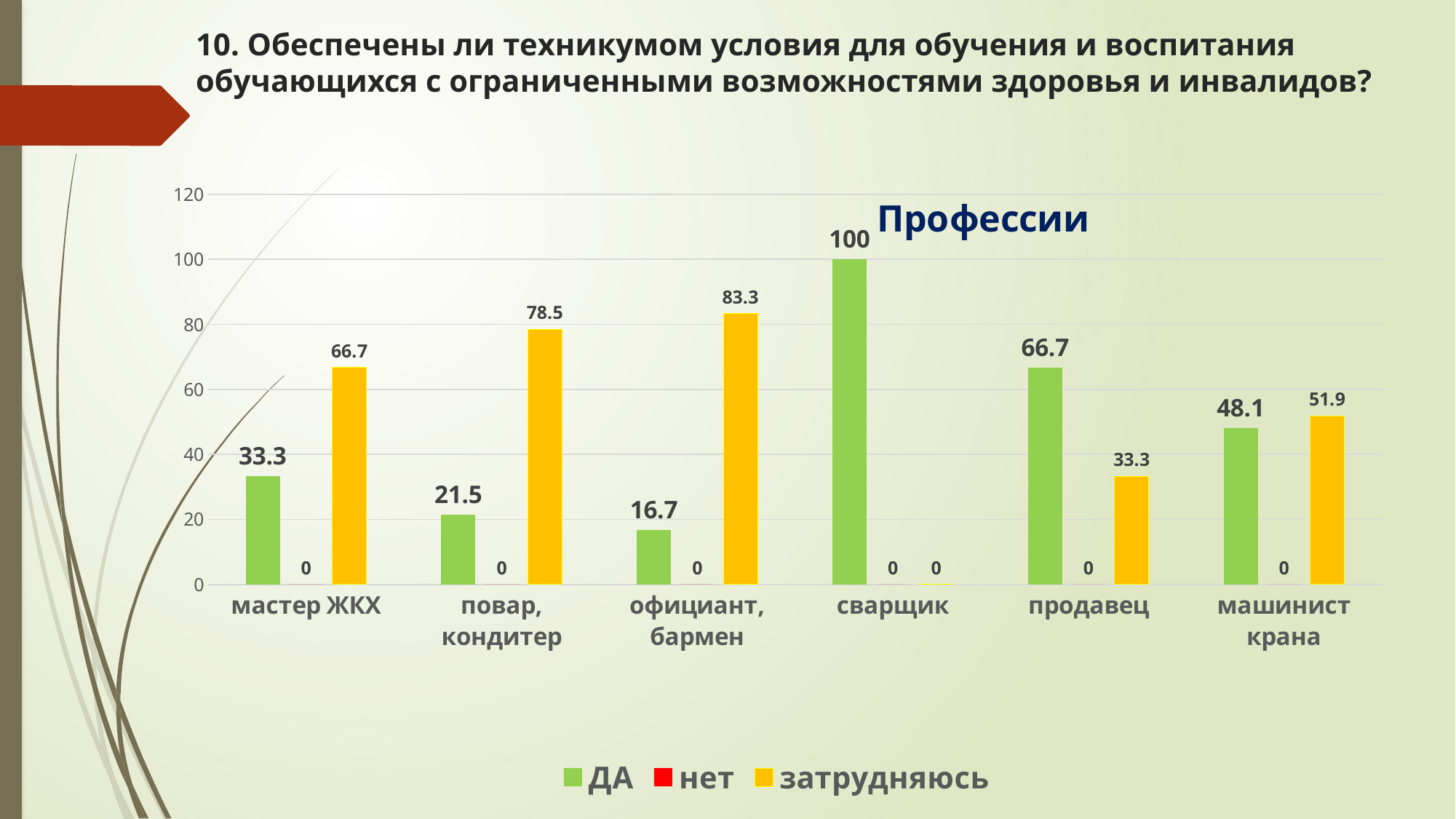
Which profession has the highest ДА value? сварщик Which profession has the lowest ДА value? официант, бармен What is the value of нет for мастер ЖКХ? 0 How many series does the legend list? 3 How many profession categories are shown on the x axis? 6 What is the title printed on the chart? Профессии What is the value of ДА for сварщик? 100 What type of chart is shown on the slide? bar chart What is the difference between the затрудняюсь and ДА values for повар, кондитер? 57 Which is larger for продавец: ДА or затрудняюсь? ДА What is the value of ДА for машинист крана? 48.1 What is the value of затрудняюсь for официант, бармен? 83.3